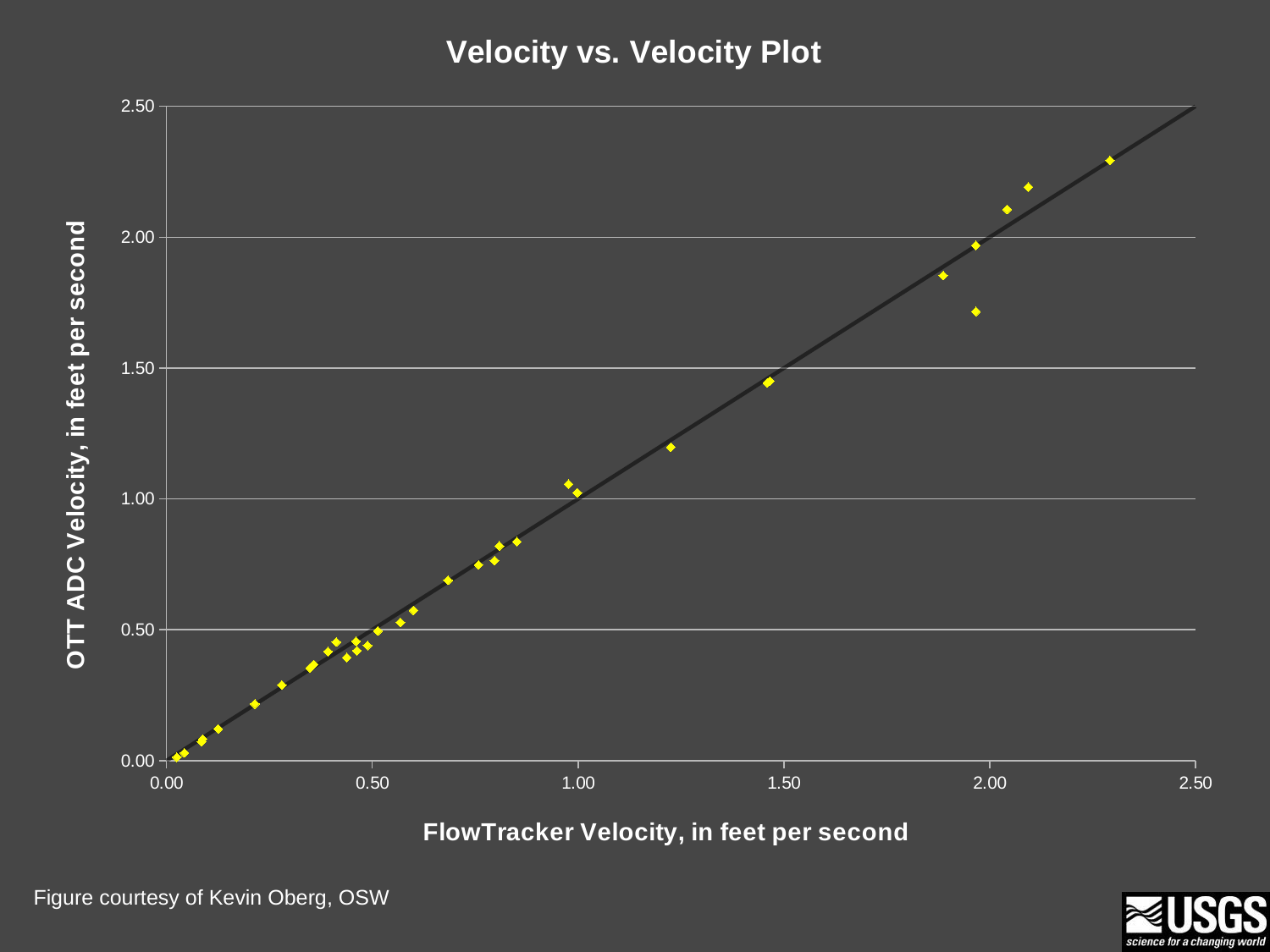
Is the OTT ADC velocity of the point near 1.89 on the x axis greater or less than 1.50? greater Is the OTT ADC velocity of the point near 0.22 on the x axis greater or less than 0.50? less Is the OTT ADC velocity of the point near 0.69 on the x axis greater or less than 0.50? greater What is the title of the chart? Velocity vs. Velocity Plot What kind of chart is shown on the slide? scatter plot What is the label of the vertical axis? OTT ADC Velocity, in feet per second Do the OTT ADC velocity values rise or fall as FlowTracker velocity increases along the x axis? rise